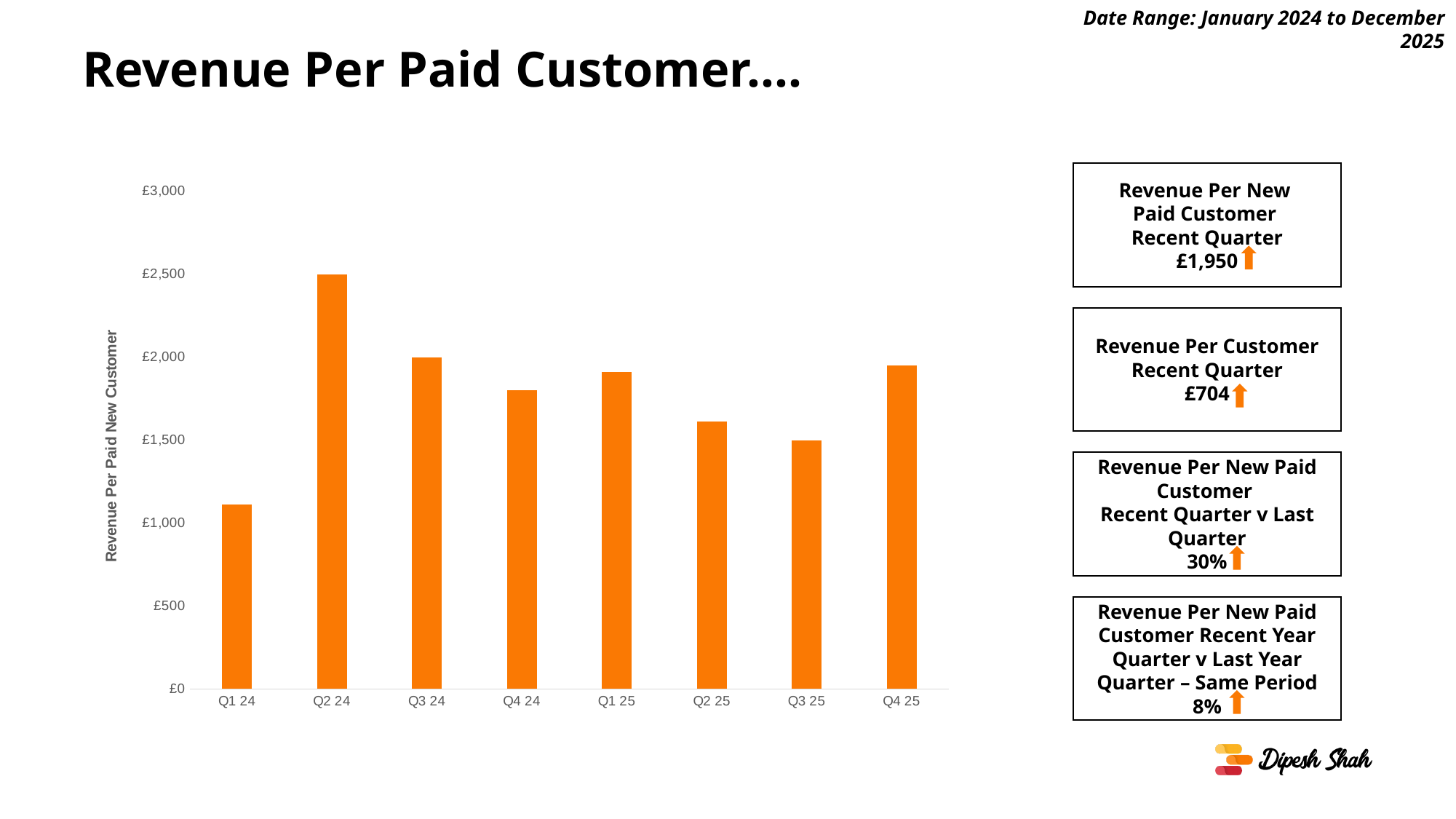
Which is larger, the value for Q1 25 or the value for Q2 25? Q1 25 Which quarter has the highest revenue per paid new customer? Q2 24 Is the value for Q4 24 greater or less than £2,000? less How many quarters are plotted on the x axis of the chart? 8 What is the label on the vertical axis of the chart? Revenue Per Paid New Customer Is the value for Q2 25 greater or less than £1,500? greater Is the value for Q1 25 greater or less than £1,500? greater Which quarter has the lowest revenue per paid new customer? Q1 24 Which is larger, the value for Q3 25 or the value for Q4 25? Q4 25 What kind of chart is shown on the slide? bar chart